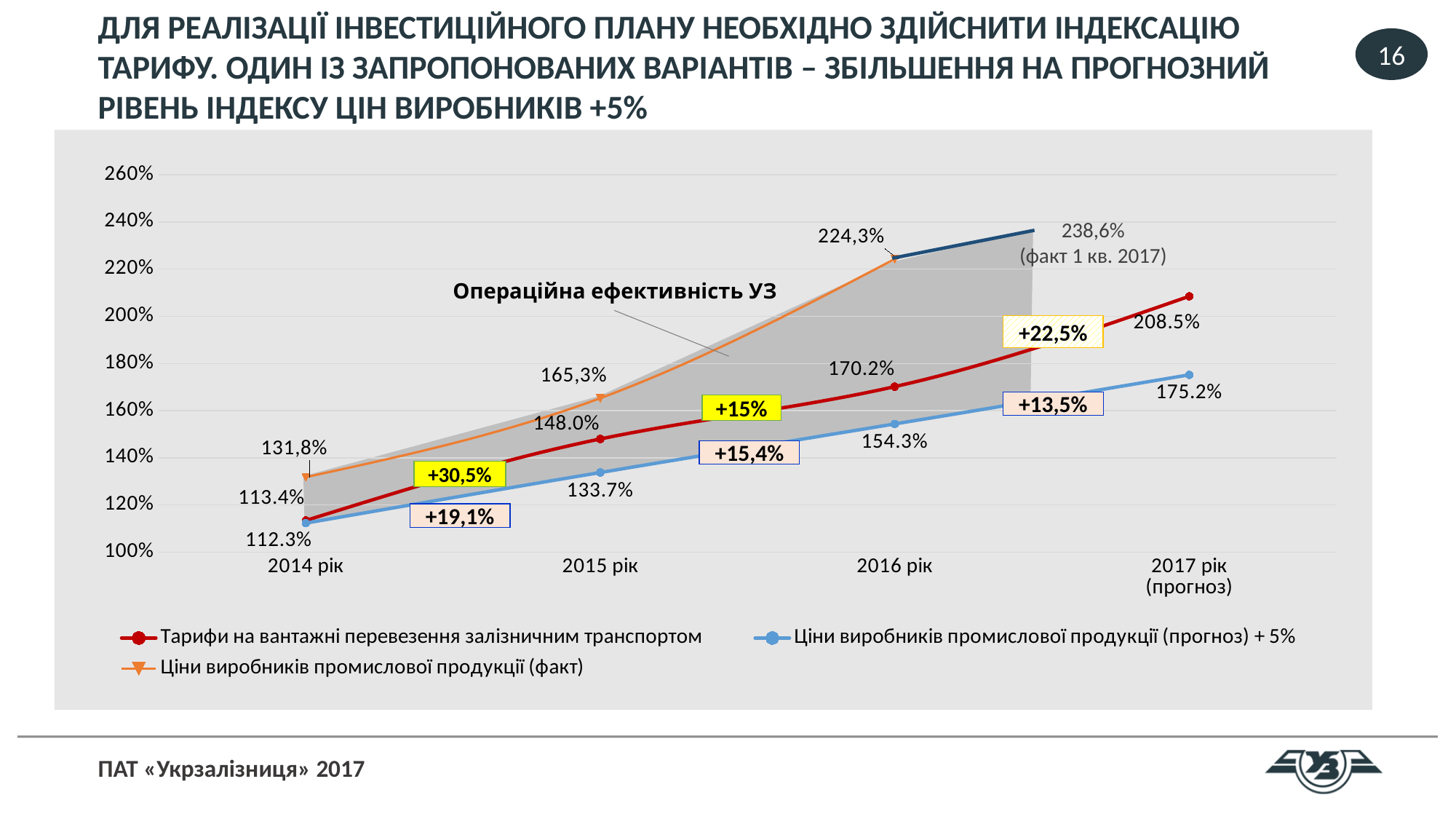
Which is larger in 2016 рік: 'Ціни виробників промислової продукції (факт)' or 'Тарифи на вантажні перевезення залізничним транспортом'? Ціни виробників промислової продукції (факт) What is the value of 'Ціни виробників промислової продукції (прогноз) + 5%' for 2017 рік (прогноз)? 175.2% Does 'Ціни виробників промислової продукції (прогноз) + 5%' rise or fall from 2014 рік to 2017 рік (прогноз)? Rise What is the value of 'Ціни виробників промислової продукції (факт)' for 2015 рік? 165,3% What is the difference between 'Тарифи на вантажні перевезення залізничним транспортом' and 'Ціни виробників промислової продукції (прогноз) + 5%' in 2017 рік (прогноз)? 33.3 percentage points What is the value of 'Тарифи на вантажні перевезення залізничним транспортом' for 2016 рік? 170.2% What type of chart is shown on the slide? Line chart In which year is 'Ціни виробників промислової продукції (факт)' highest? 2016 рік How many years are shown on the x axis? 4 What growth percentage is shown in the yellow box between 2014 рік and 2015 рік for the tariff series? +30,5% In which year is 'Тарифи на вантажні перевезення залізничним транспортом' lowest? 2014 рік How many series does the legend list? 3